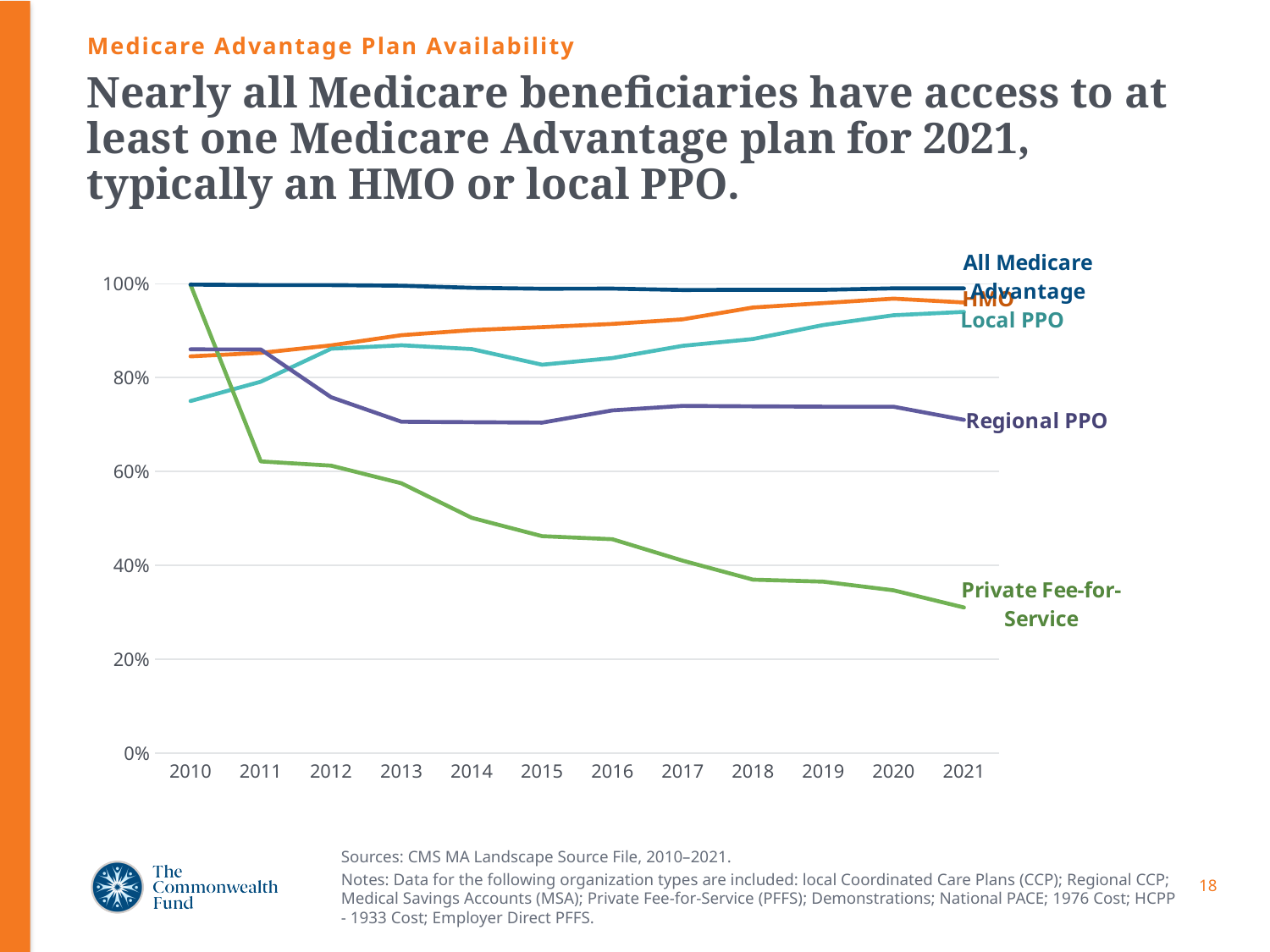
Is the value for Local PPO in 2010 greater or less than 80%? less How many series (plan types) are plotted on the chart? 5 Which plan type has the highest value in 2021? All Medicare Advantage Does the Private Fee-for-Service line rise or fall from 2010 to 2021? Fall In 2010, which is larger: Regional PPO or Local PPO? Regional PPO Is the value for Private Fee-for-Service in 2021 greater or less than 40%? less Is the value for Regional PPO in 2021 greater or less than 80%? less Does the Local PPO line rise or fall overall from 2010 to 2021? Rise In 2021, which is larger: Local PPO or Regional PPO? Local PPO How many years are plotted along the x axis? 12 Which plan type has the lowest value in 2021? Private Fee-for-Service What kind of chart is shown on the slide? Line chart